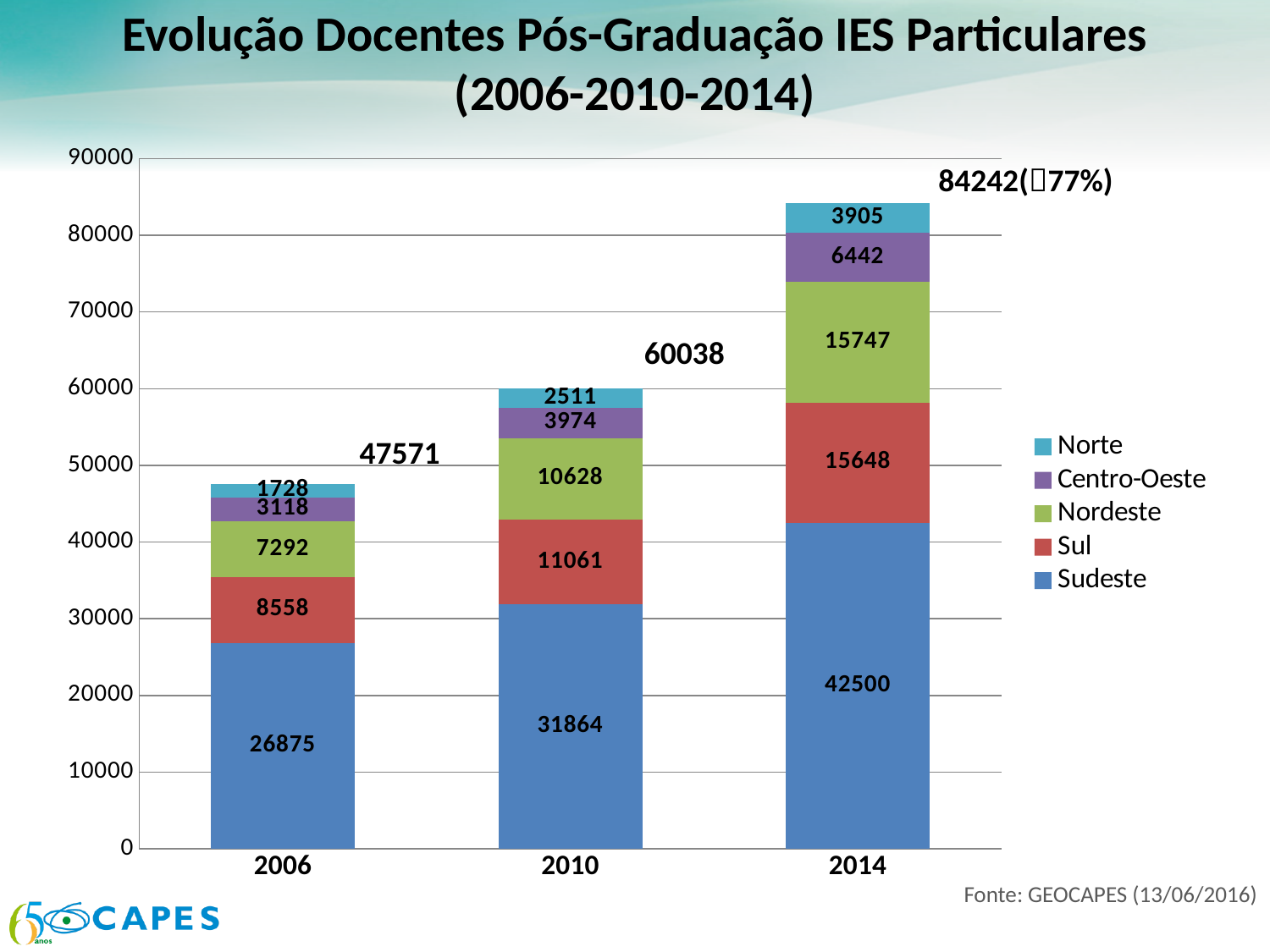
Is the total for 2014 greater or less than 80000? greater What is the difference between the Sul values for 2014 and 2006? 7090 Which is larger in 2014, Nordeste or Sul? Nordeste What is the value for Sudeste in 2014? 42500 What is the value for Nordeste in 2010? 10628 What kind of chart is shown? Stacked bar chart What is the total of the stacked bar for 2006? 47571 Which year has the highest total? 2014 What is the value for Norte in 2006? 1728 What is the total of the stacked bar for 2010? 60038 How many series does the legend list? 5 Do the totals rise or fall from 2006 to 2014? Rise